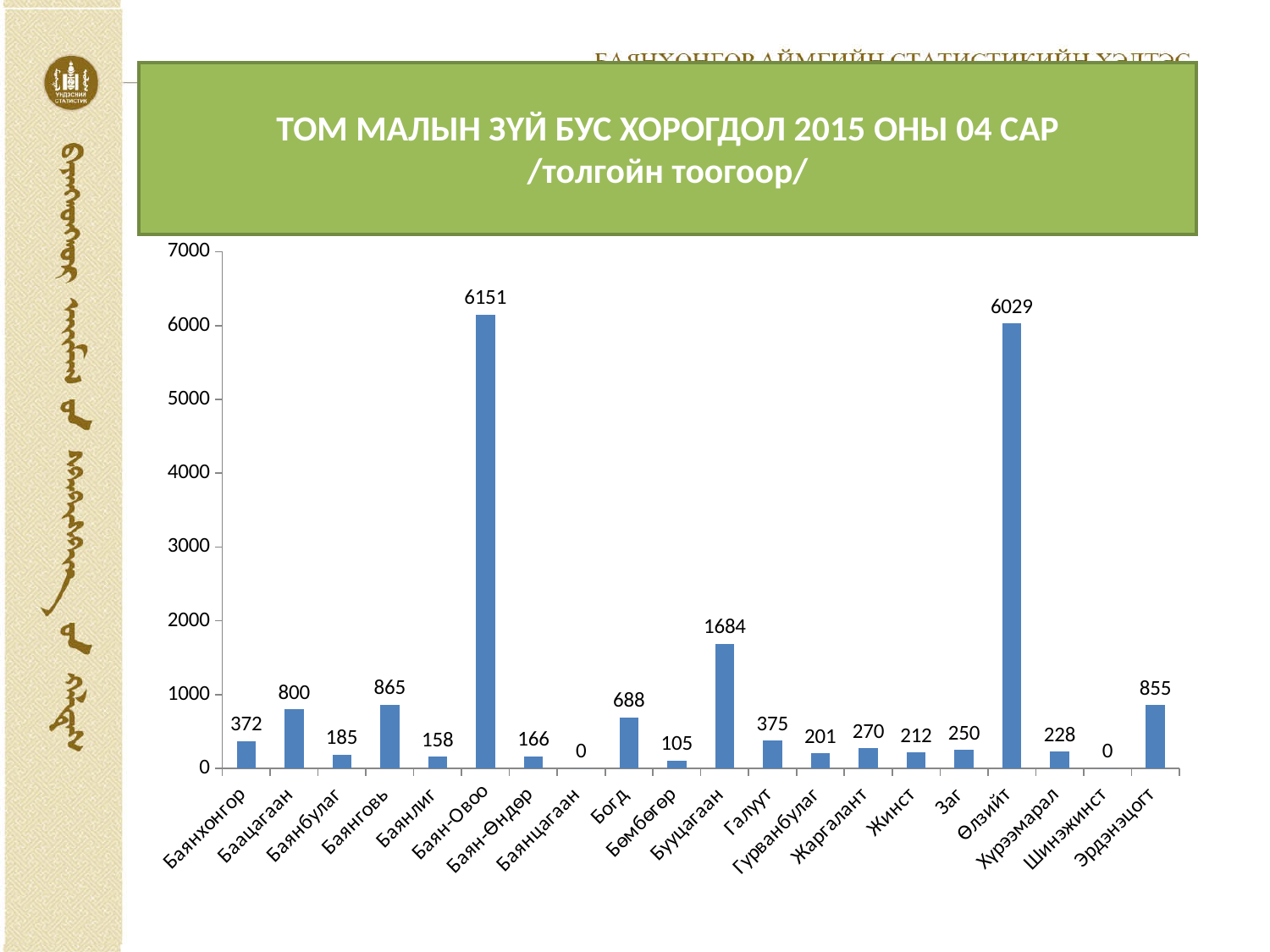
How many categories are shown on the x axis? 20 What is the value for Бууцагаан? 1684 Which category has the highest value? Баян-Овоо Which is larger, the value for Богд or the value for Баянхонгор? Богд What is the difference between the values for Баянговь and Баацагаан? 65 What is the value for Бөмбөгөр? 105 What is the value for Эрдэнэцогт? 855 How many categories have a value of 0? 2 What is the value for Баян-Овоо? 6151 What is the difference between the values for Баян-Овоо and Өлзийт? 122 Is the value for Бууцагаан greater or less than 1000? greater What kind of chart is shown on the slide? bar chart